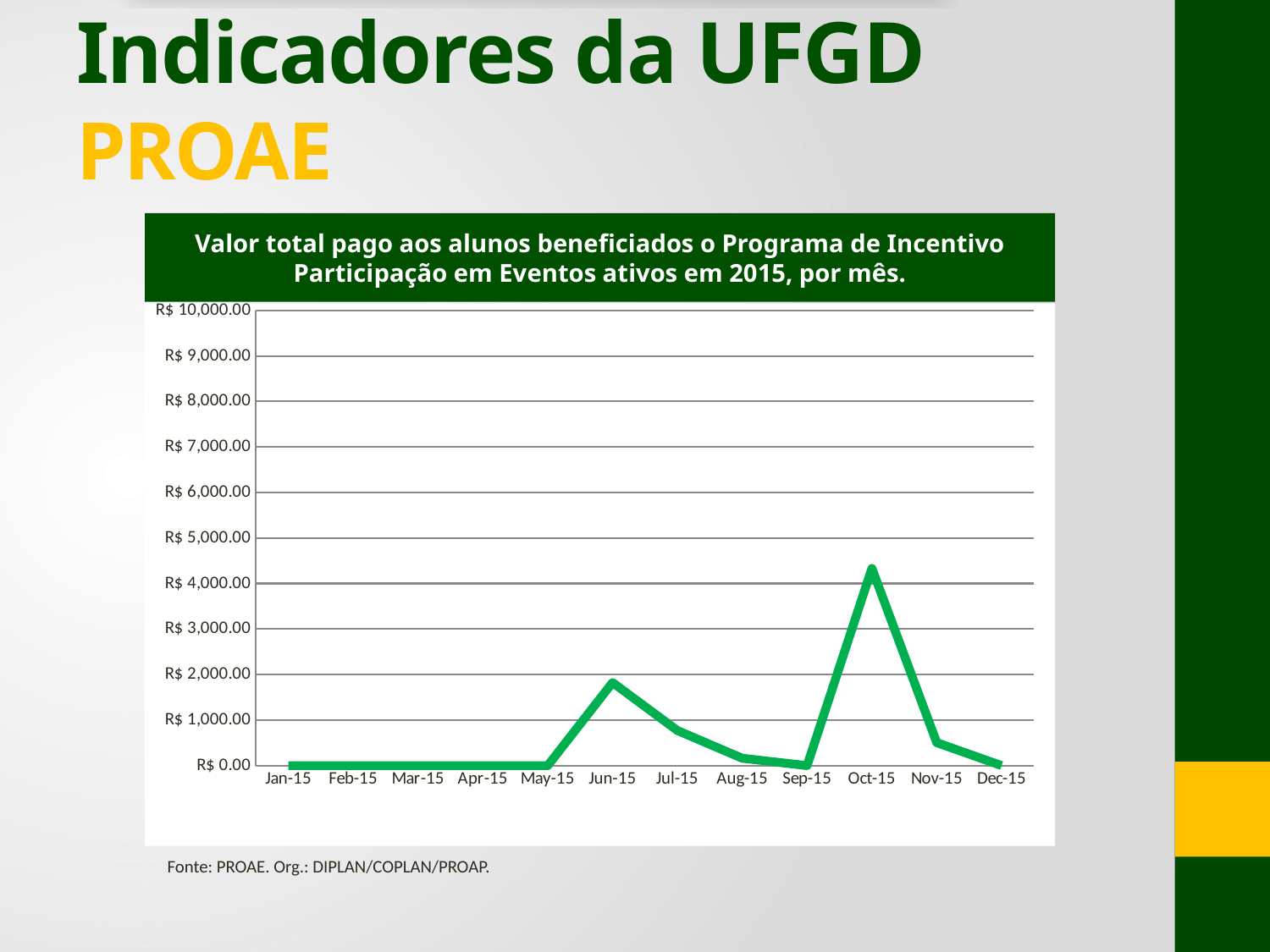
Which is larger, the value for Jun-15 or the value for Jul-15? Jun-15 Do the values rise or fall from Oct-15 to Dec-15? fall Which month has the highest value paid? Oct-15 How many months are plotted along the x axis? 12 Is the value for Nov-15 greater or less than R$ 1,000.00? less Is the value for Jul-15 greater or less than R$ 1,000.00? less Is the value for Jun-15 greater or less than R$ 2,000.00? less What kind of chart is shown on the slide? line chart Which is larger, the value for Jun-15 or the value for Oct-15? Oct-15 What is the maximum value shown on the vertical axis? R$ 10,000.00